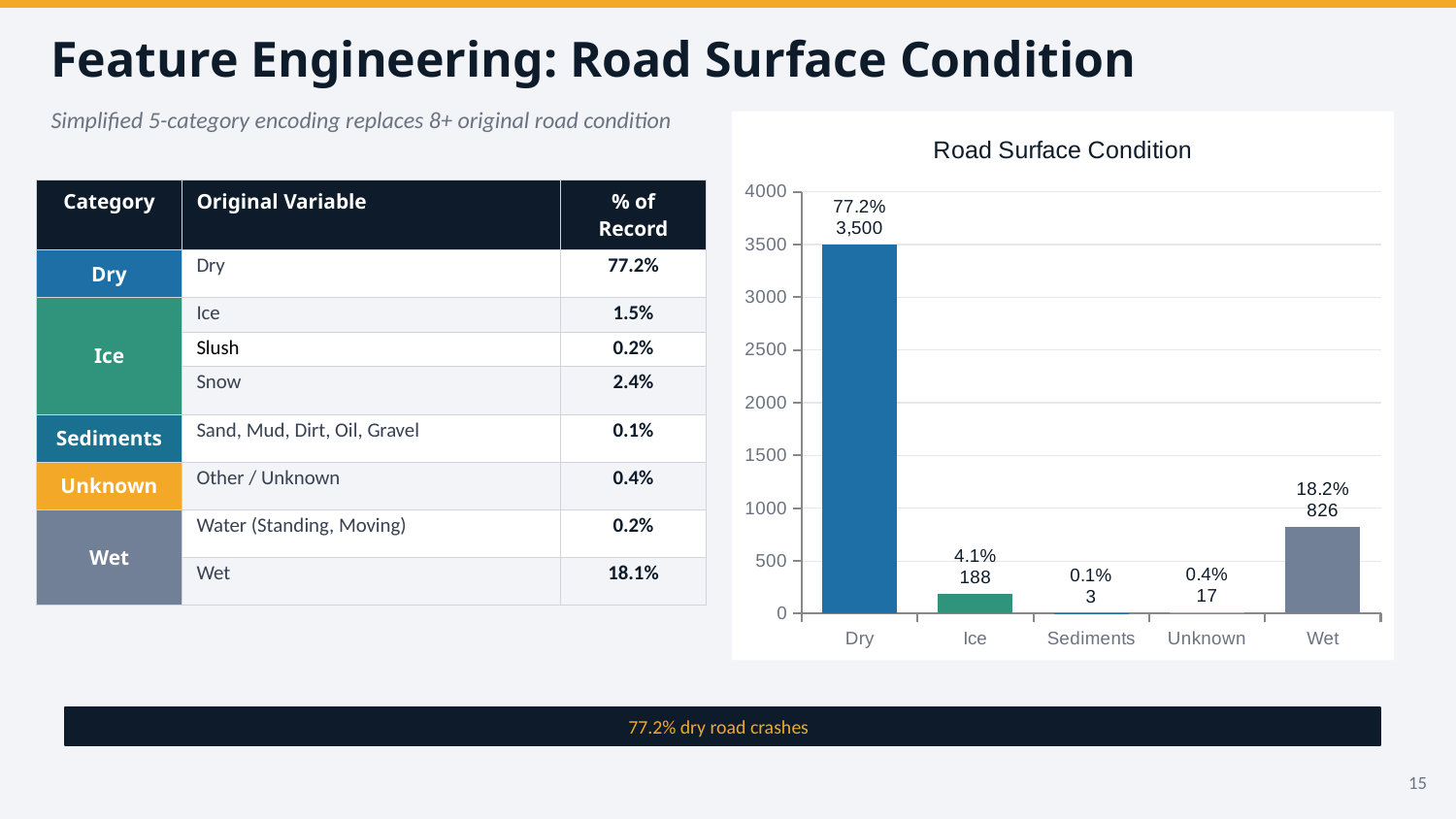
What is the value for Dry in the Road Surface Condition chart? 3,500 Which is larger in the Road Surface Condition chart, Ice or Unknown? Ice What percentage is shown above the Unknown bar in the Road Surface Condition chart? 0.4% What is the value for Wet in the Road Surface Condition chart? 826 Which category has the lowest value in the Road Surface Condition chart? Sediments What is the title of the chart on the slide? Road Surface Condition Which category has the highest value in the Road Surface Condition chart? Dry What is the difference between the Dry and Wet values in the Road Surface Condition chart? 2,674 What is the value for Ice in the Road Surface Condition chart? 188 What kind of chart is the Road Surface Condition chart? Bar chart Is the value for Wet greater or less than 1000 in the Road Surface Condition chart? less How many categories are shown on the x axis of the Road Surface Condition chart? 5